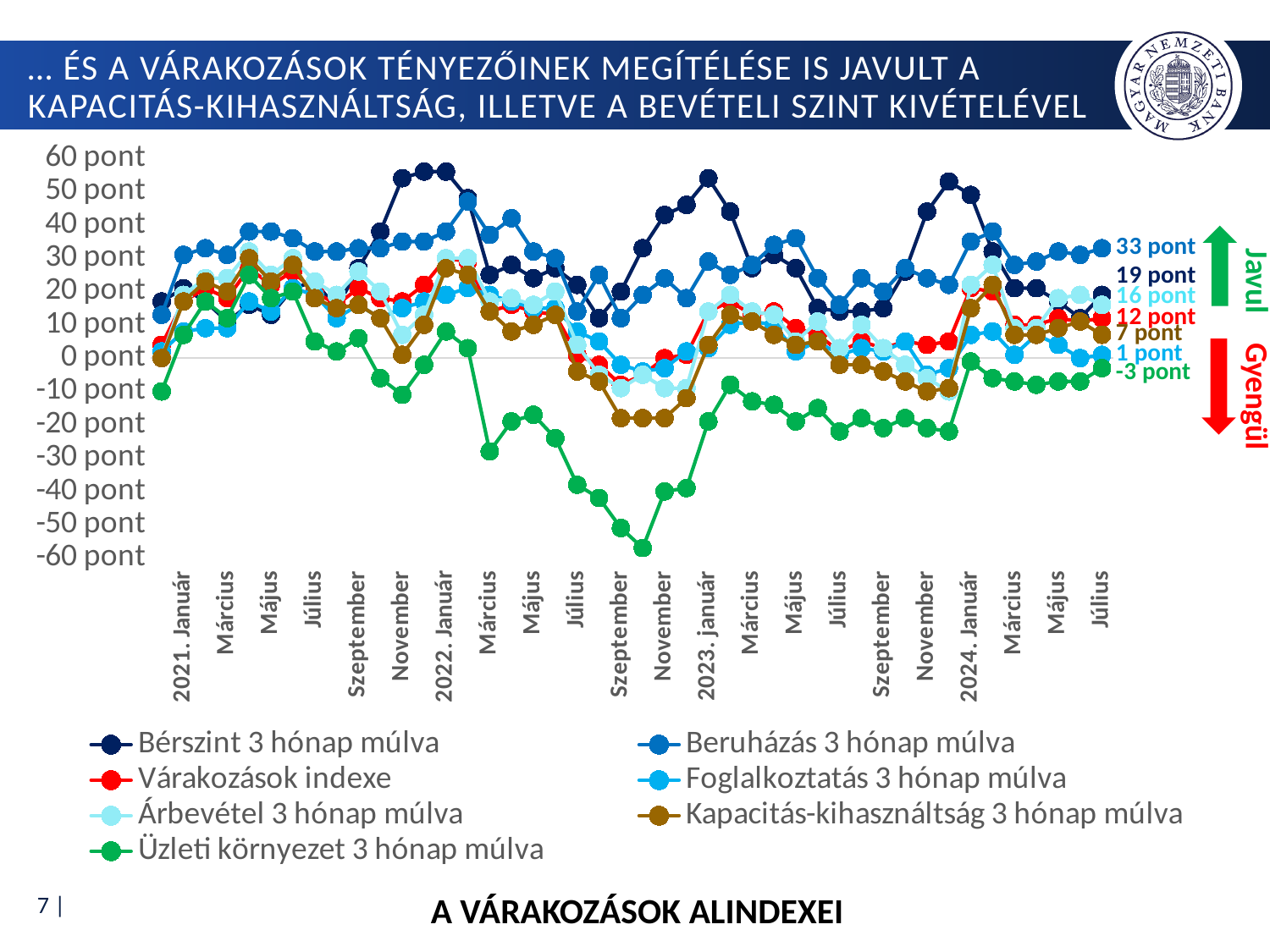
Which series has the lowest labelled value at the end of the chart? Üzleti környezet 3 hónap múlva How many series does the legend list? 7 What is the latest labelled value for the Beruházás 3 hónap múlva series? 33 pont What is the latest labelled value for the Kapacitás-kihasználtság 3 hónap múlva series? 7 pont What is the latest labelled value for the Bérszint 3 hónap múlva series? 19 pont What is the latest labelled value for the Üzleti környezet 3 hónap múlva series? -3 pont Is the end-of-chart value for Árbevétel 3 hónap múlva larger or smaller than that for Foglalkoztatás 3 hónap múlva? larger What kind of chart is shown on the slide? line chart Which series has the highest labelled value at the end of the chart? Beruházás 3 hónap múlva What is the difference between the end-of-chart labelled values of Beruházás 3 hónap múlva (33 pont) and Bérszint 3 hónap múlva (19 pont)? 14 pont What is the latest labelled value for the Várakozások indexe series? 12 pont